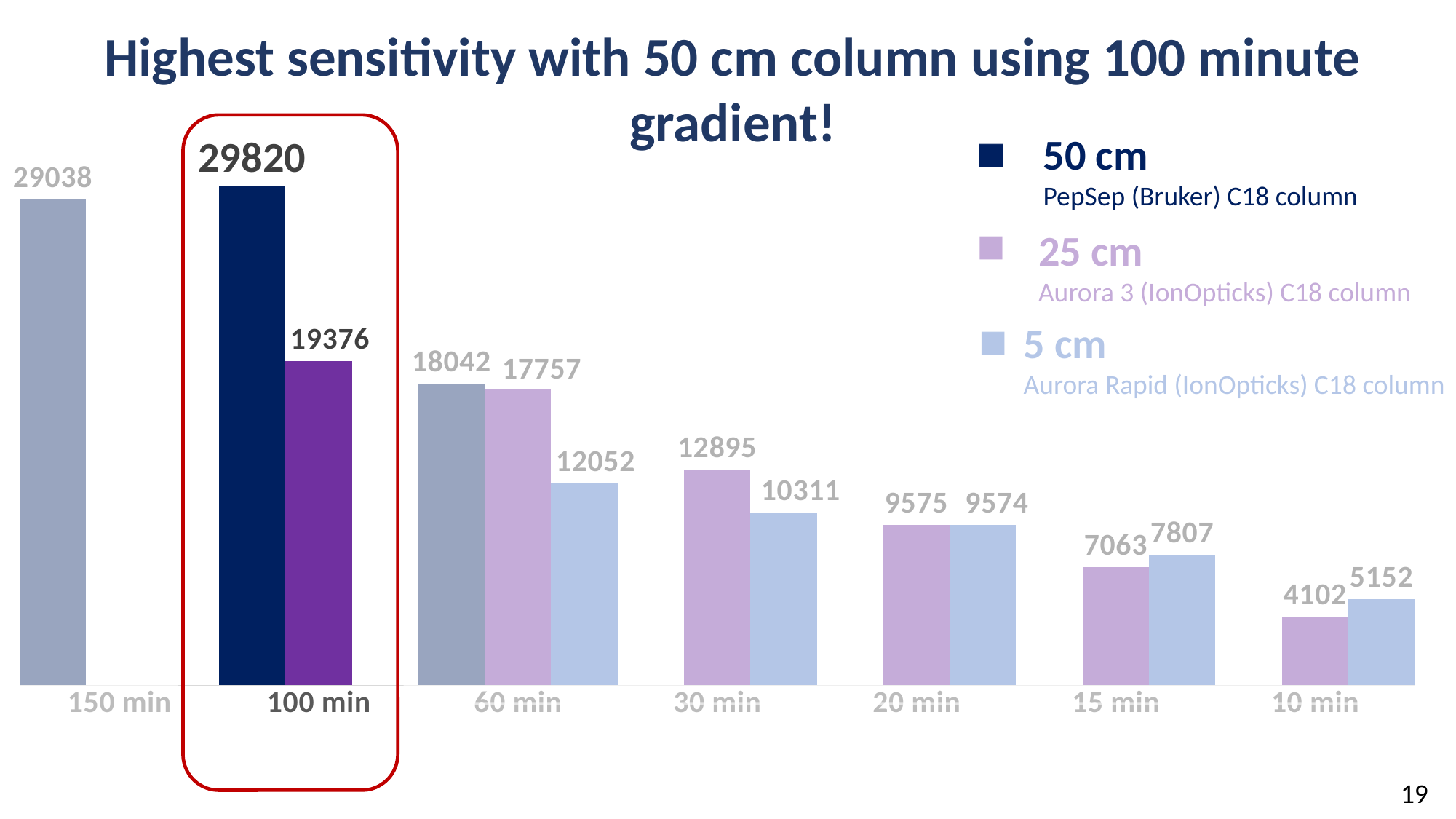
Which gradient time has the highest value for the 50 cm column? 100 min At the 15 min gradient, which is larger: the 25 cm column or the 5 cm column? 5 cm What is the value for the 25 cm column at the 60 min gradient? 17757 What is the difference between the 50 cm and 25 cm values at the 100 min gradient? 10444 What is the difference between the 5 cm and 25 cm values at the 10 min gradient? 1050 What kind of chart is shown on the slide? bar chart How many gradient times are shown on the x axis? 7 What is the value for the 50 cm column at the 150 min gradient? 29038 How many series does the legend list? 3 What is the value for the 50 cm column at the 100 min gradient? 29820 Which gradient time has the lowest value for the 25 cm column? 10 min What is the value for the 5 cm column at the 30 min gradient? 10311